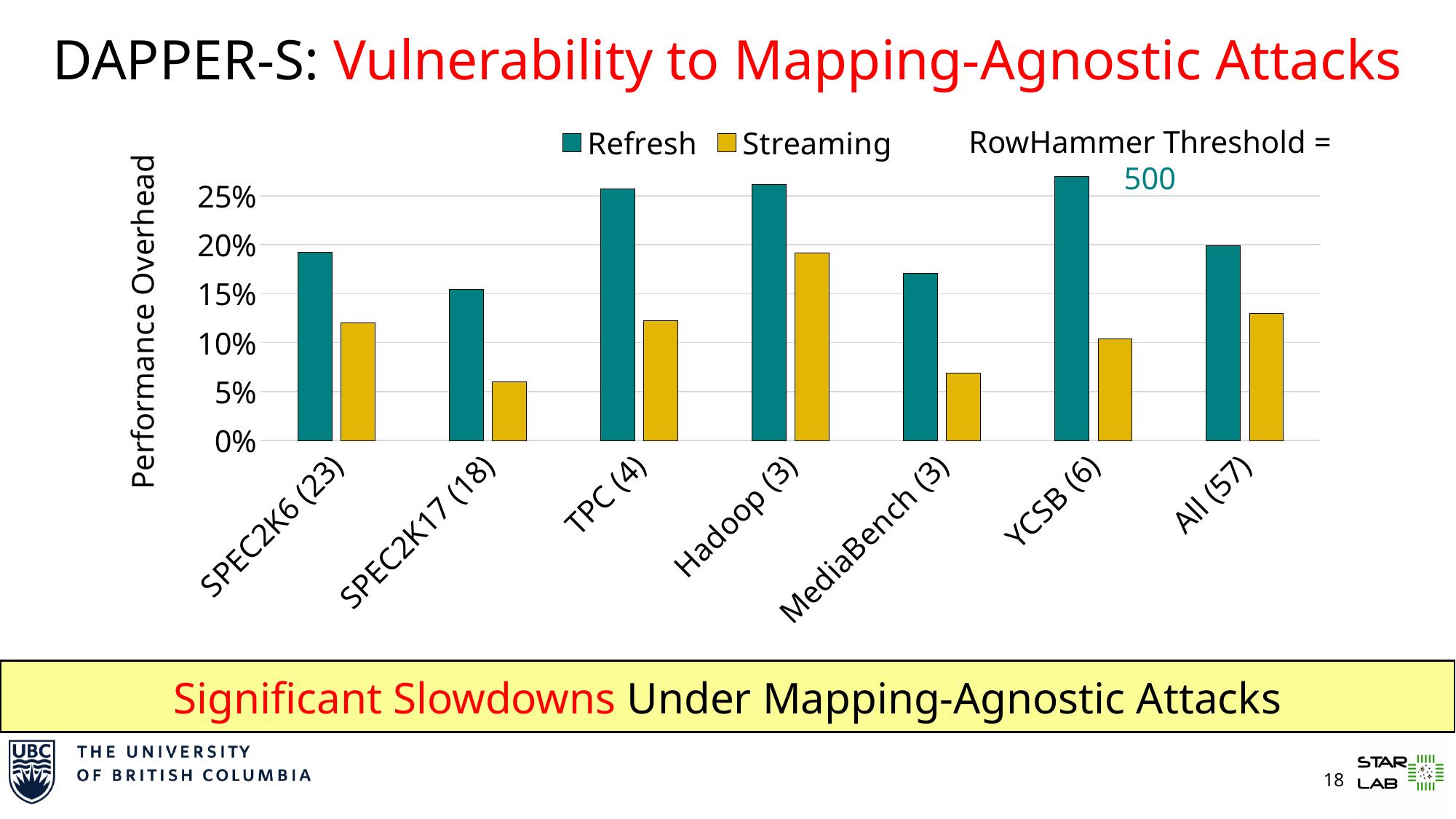
Which category has the highest Streaming performance overhead? Hadoop (3) How many series does the legend list? 2 How many workload categories are shown on the x axis? 7 Is the Streaming value for SPEC2K17 (18) greater or less than 10%? less What RowHammer Threshold value is stated on the chart? 500 Is the Streaming value for Hadoop (3) greater or less than 15%? greater What kind of chart is shown on the slide? bar chart Is the Refresh value for YCSB (6) greater or less than 25%? greater For MediaBench (3), which is larger: the Refresh or the Streaming overhead? Refresh Which is larger: the Streaming overhead for Hadoop (3) or for SPEC2K6 (23)? Hadoop (3) Which category has the lowest Refresh performance overhead? SPEC2K17 (18)